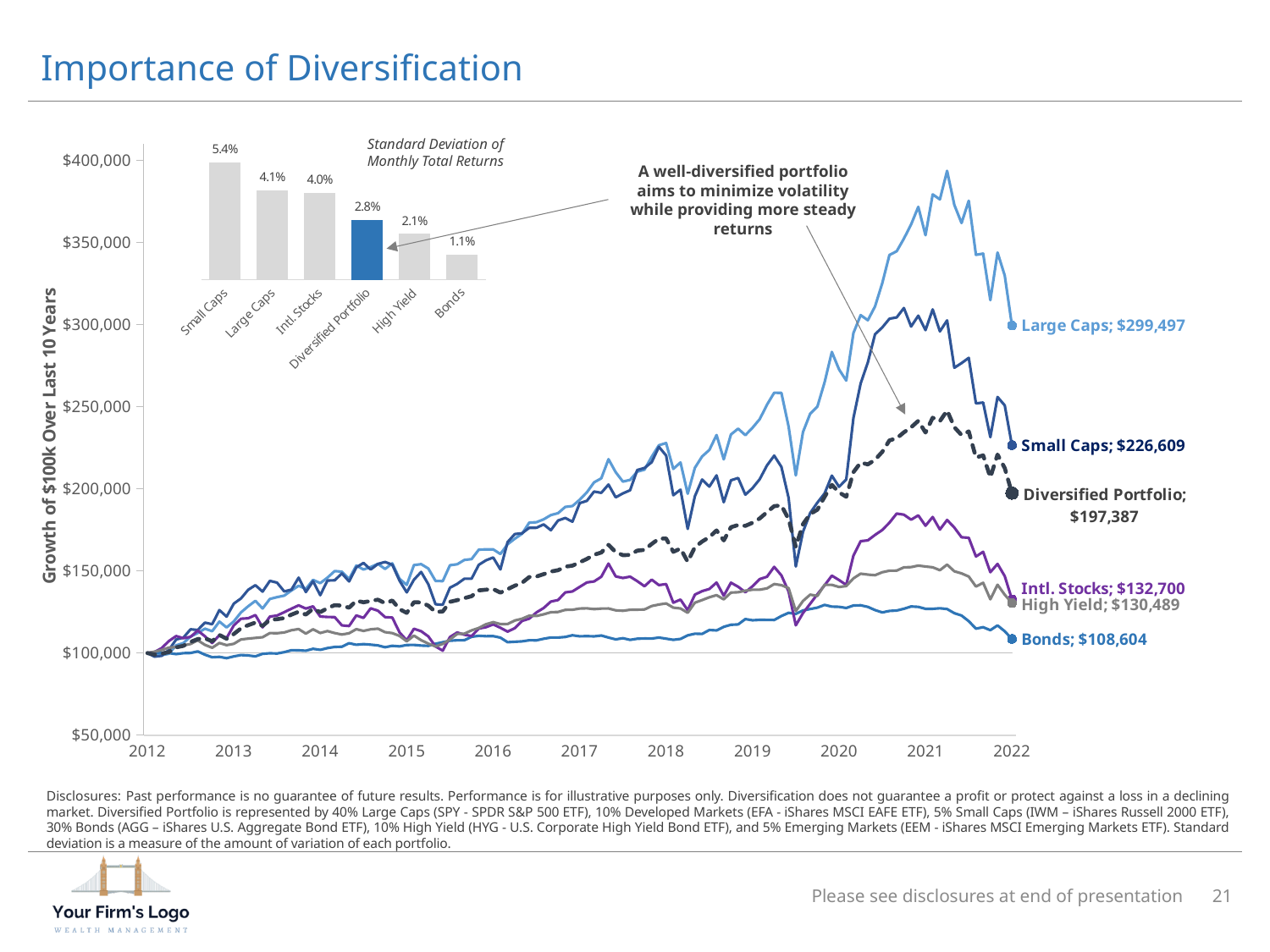
In the Standard Deviation of Monthly Total Returns bar chart, how many categories are shown? 6 In the Standard Deviation of Monthly Total Returns bar chart, what is the value for Small Caps? 5.4% In the Standard Deviation of Monthly Total Returns bar chart, which category has the highest value? Small Caps In the Growth of $100k Over Last 10 Years line chart, what is the ending value for the Diversified Portfolio? $197,387 In the Standard Deviation of Monthly Total Returns bar chart, which category has the lowest value? Bonds In the Growth of $100k Over Last 10 Years line chart, what is the ending value for Large Caps? $299,497 In the Standard Deviation of Monthly Total Returns bar chart, what is the value for the Diversified Portfolio? 2.8% In the Standard Deviation of Monthly Total Returns bar chart, what is the difference between Large Caps and High Yield? 2.0% In the Growth of $100k Over Last 10 Years line chart, what is the ending value for Bonds? $108,604 In the Growth of $100k Over Last 10 Years line chart, what is the difference between the ending values of Small Caps and Intl. Stocks? $93,909 In the Growth of $100k Over Last 10 Years line chart, which ends higher, Intl. Stocks or High Yield? Intl. Stocks What type of chart is the large chart showing Growth of $100k Over Last 10 Years? Line chart